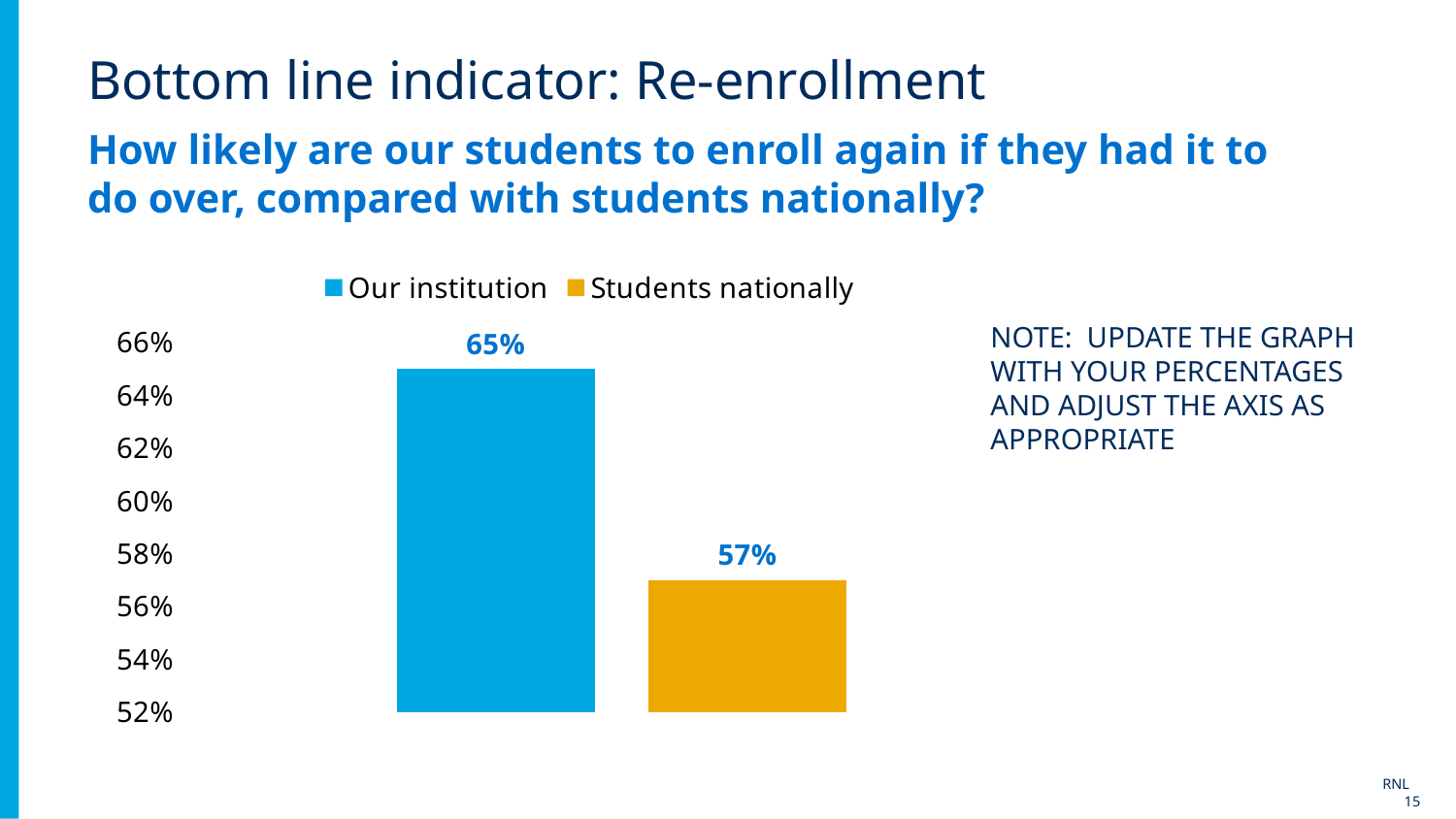
What kind of chart is shown on the slide? Bar chart How many series does the legend list? 2 How many bars are plotted on the chart? 2 What is the difference between the value for Our institution and the value for Students nationally? 8% Which is larger, the value for Our institution or the value for Students nationally? Our institution What colour is the bar for Students nationally? Yellow Which series has the lowest value? Students nationally What is the value for Our institution? 65% Is the value for Students nationally greater or less than 60%? less Which series has the highest value? Our institution Is the value for Our institution greater or less than 62%? greater What is the value for Students nationally? 57%